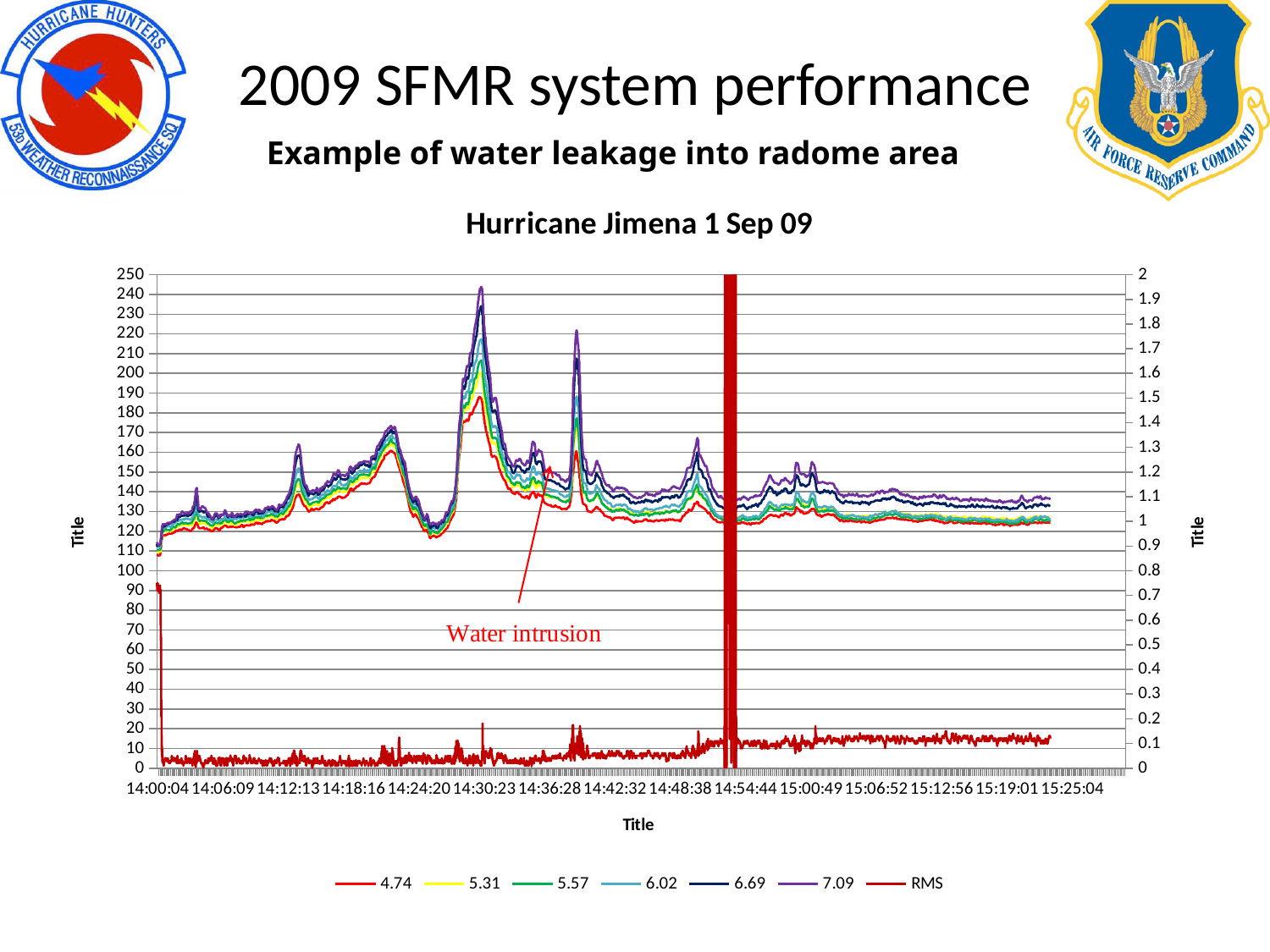
At the peak near 14:30:23, which series is larger, 7.09 or 4.74? 7.09 What kind of chart is shown on the slide? line chart Do the values of the 7.09 series rise or fall between 14:24:20 and 14:30:23? rise What text does the red arrow annotation on the chart point with? Water intrusion How many series does the legend list? 7 Among the series 4.74, 5.31, 5.57, 6.02, 6.69 and 7.09, which is plotted lowest? 4.74 Is the peak value of the 4.74 series near 14:30:23 greater or less than 170 on the left axis? greater Is the peak value of the 7.09 series near 14:30:23 greater or less than 200 on the left axis? greater What is the title of the chart? Hurricane Jimena 1 Sep 09 Is the RMS series after 15:00:49 greater or less than 50 on the left axis scale? less How many time labels are shown on the x axis? 15